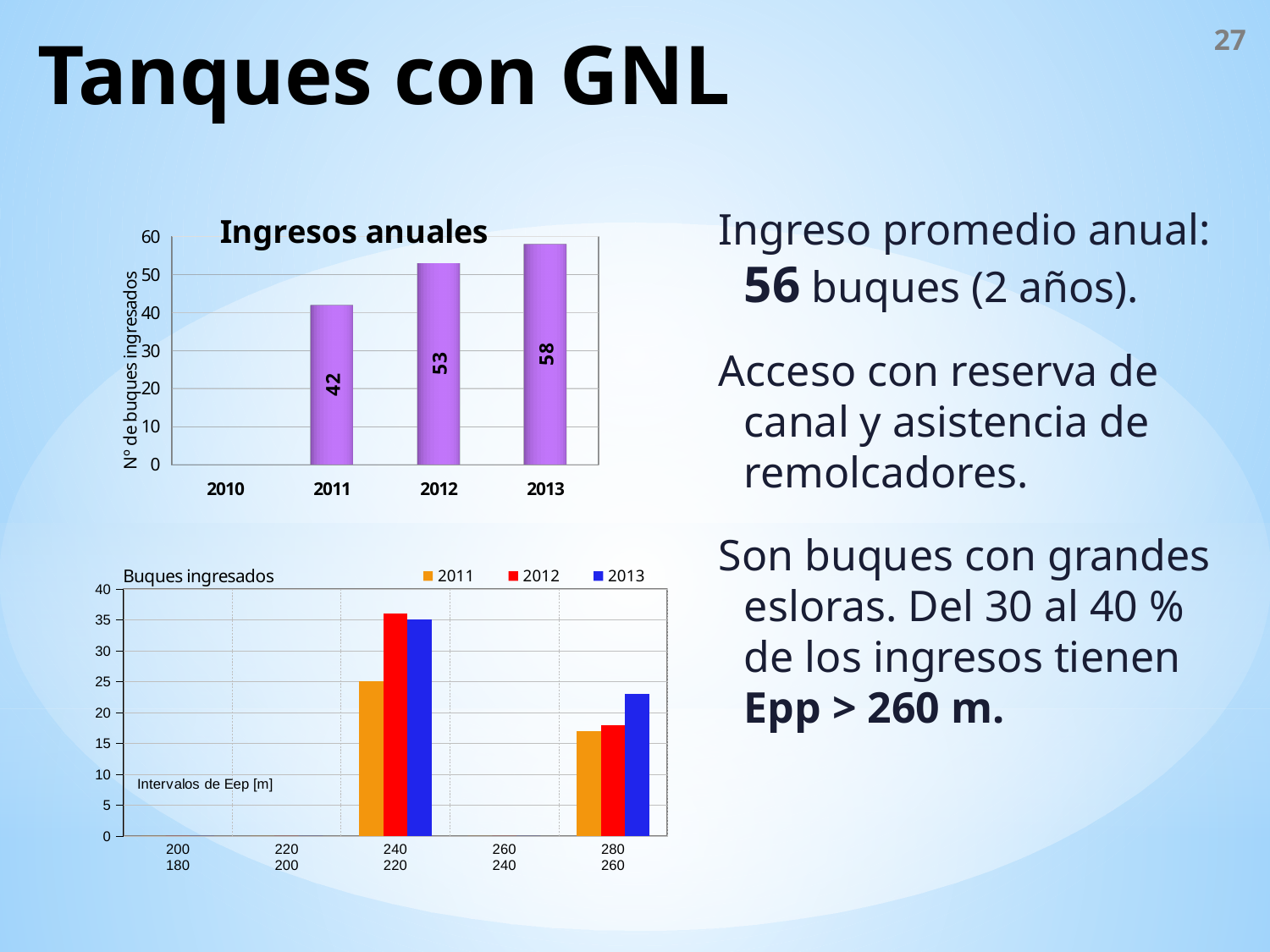
In the 'Buques ingresados' chart, how many series does the legend list? 3 In the 'Ingresos anuales' chart, what is the y-axis label? Nº de buques ingresados In the 'Ingresos anuales' chart, what is the difference between the values for 2013 and 2011? 16 In the 'Ingresos anuales' chart, do the values rise or fall from 2011 to 2013? rise In the 'Ingresos anuales' chart, what is the value for 2011? 42 In the 'Buques ingresados' chart, is the value for 2012 in the 240/220 interval greater or less than 30? greater In the 'Ingresos anuales' chart, which year has the highest number of buques ingresados? 2013 In the 'Ingresos anuales' chart, what is the value for 2012? 53 In the 'Ingresos anuales' chart, which is larger, the value for 2012 or the value for 2013? 2013 In the 'Buques ingresados' chart, which series has the tallest bar in the 280/260 interval? 2013 What kind of chart is the 'Ingresos anuales' chart? bar chart In the 'Buques ingresados' chart, is the value for 2011 in the 280/260 interval greater or less than 20? less